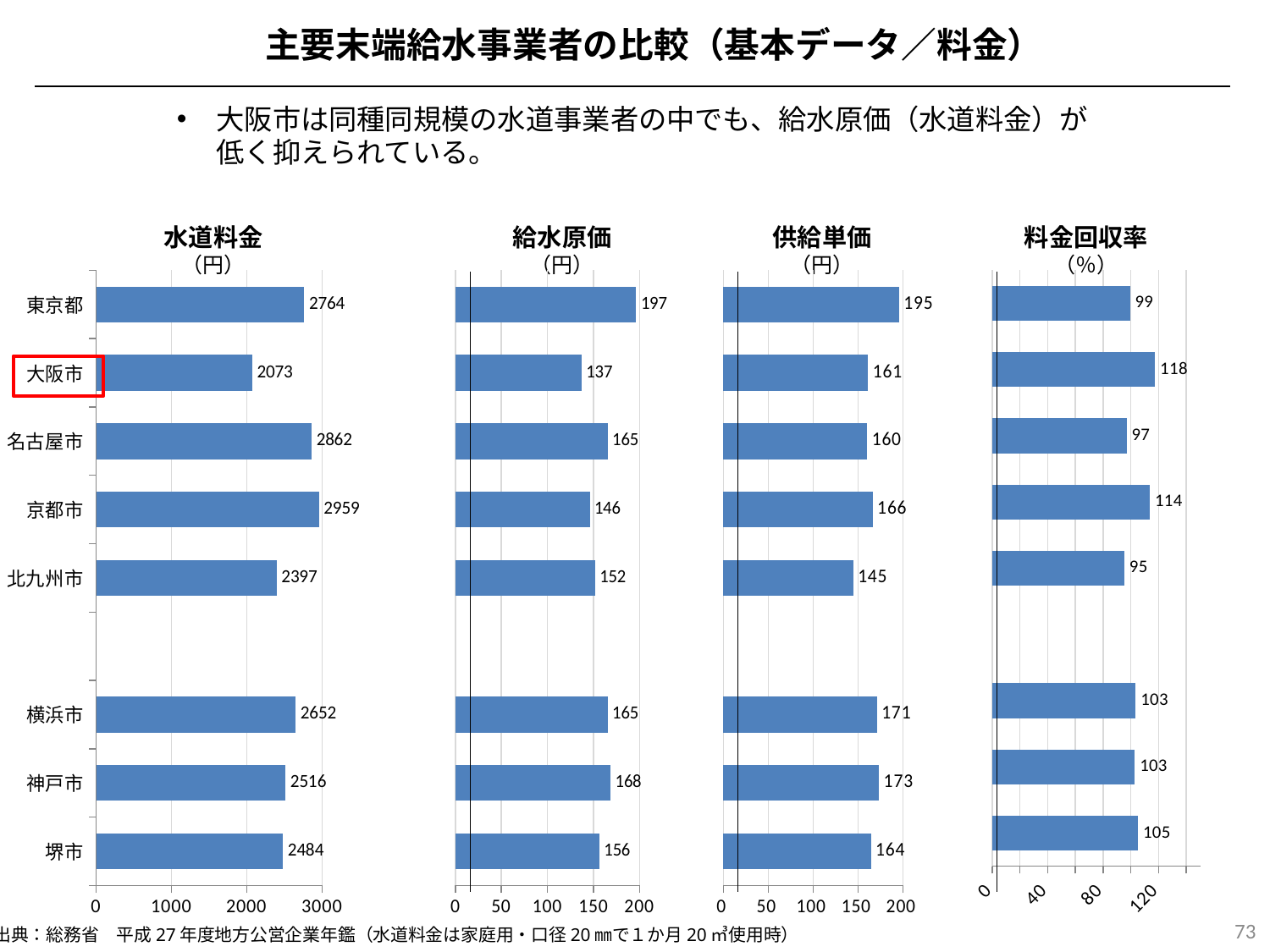
In the 水道料金 chart, which city has the highest value? 京都市 In the 供給単価 chart, what is the difference between 東京都 and 北九州市? 50 In the 供給単価 chart, which is larger, 横浜市 or 堺市? 横浜市 In the 水道料金 chart, what is the difference between 京都市 and 大阪市? 886 In the 水道料金 chart, what is the value for 大阪市? 2073 In the 料金回収率 chart, which city has the highest value? 大阪市 In the 給水原価 chart, which city has the lowest value? 大阪市 How many cities are shown in the 水道料金 chart? 8 What kind of chart is the 給水原価 chart? bar chart In the 料金回収率 chart, what is the value for 京都市? 114 In the 給水原価 chart, what is the value for 東京都? 197 What unit is shown under the title of the 料金回収率 chart? %